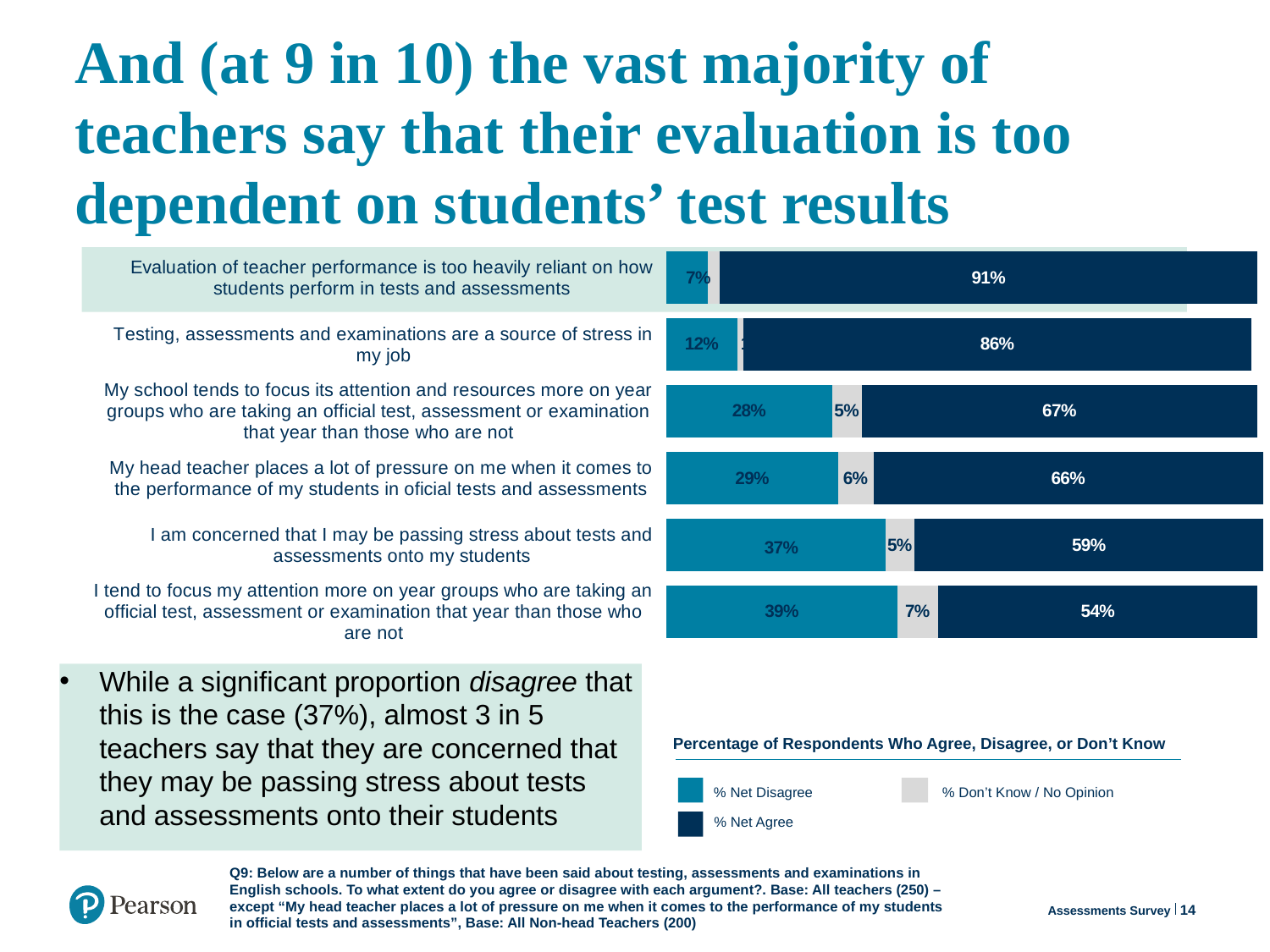
What is the total of the stacked bar for 'My school tends to focus its attention and resources more on year groups who are taking an official test, assessment or examination that year than those who are not'? 100% Which statement has the lowest % Net Agree? I tend to focus my attention more on year groups who are taking an official test, assessment or examination that year than those who are not What percentage of respondents answered Don't Know / No Opinion for the statement 'My head teacher places a lot of pressure on me when it comes to the performance of my students in official tests and assessments'? 6% What percentage of respondents net agree that evaluation of teacher performance is too heavily reliant on how students perform in tests and assessments? 91% What type of chart is shown on the slide? Stacked bar chart What is the difference in % Net Agree between 'Testing, assessments and examinations are a source of stress in my job' and 'I am concerned that I may be passing stress about tests and assessments onto my students'? 27 percentage points Which has a higher % Net Disagree: 'My school tends to focus its attention and resources more on year groups who are taking an official test...' or 'I am concerned that I may be passing stress about tests and assessments onto my students'? I am concerned that I may be passing stress about tests and assessments onto my students How many statements are shown in the chart? 6 What percentage of respondents net disagree that testing, assessments and examinations are a source of stress in their job? 12% What percentage of respondents net agree that they tend to focus their attention more on year groups who are taking an official test, assessment or examination that year than those who are not? 54% Which statement has the highest % Net Agree? Evaluation of teacher performance is too heavily reliant on how students perform in tests and assessments How many series does the chart legend list? 3